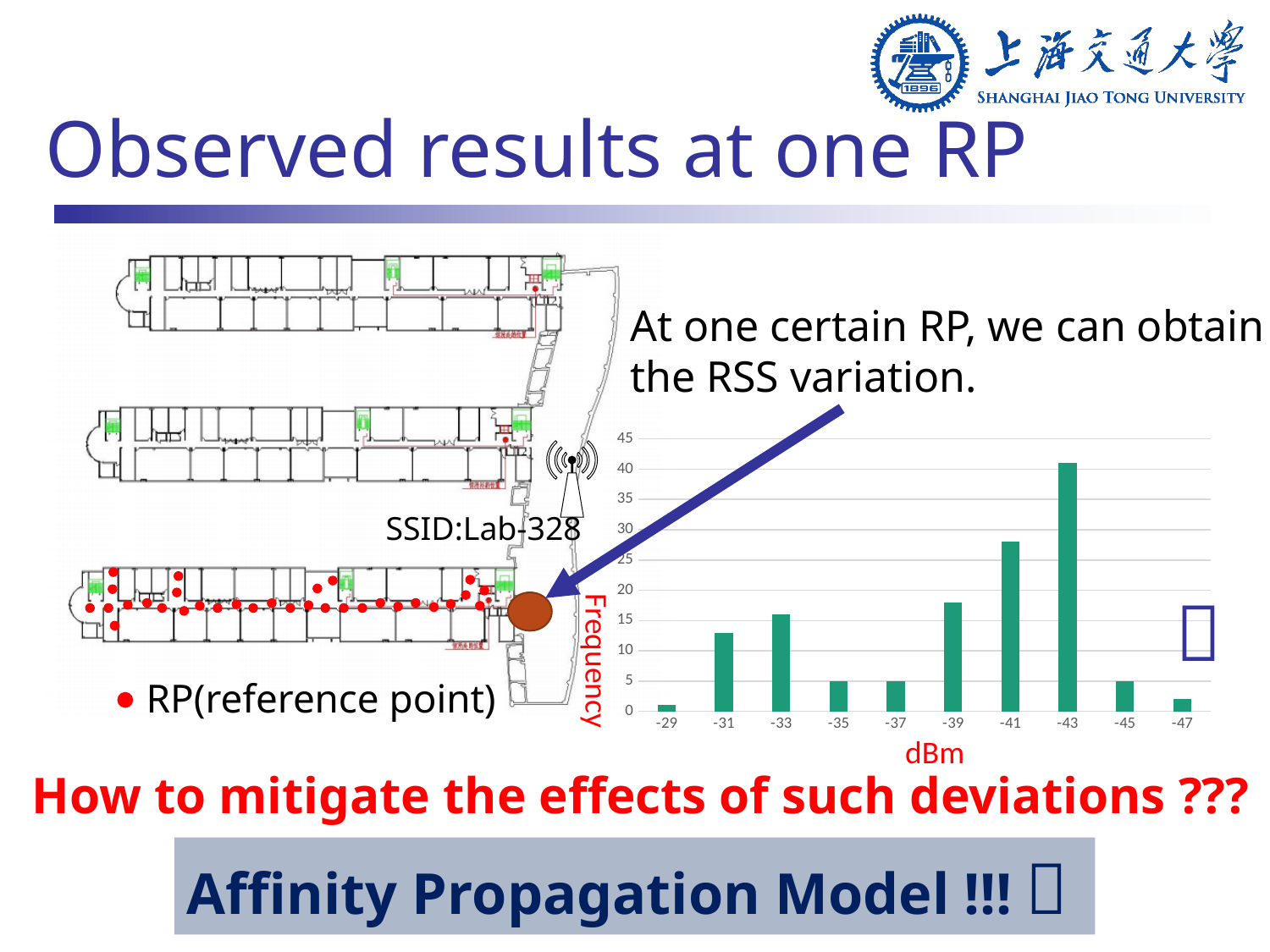
Which has a higher frequency, -31 dBm or -39 dBm? -39 Which has a higher frequency, -41 dBm or -33 dBm? -41 What is the label of the vertical axis of the chart? Frequency Which dBm value has the highest frequency in the chart? -43 Is the frequency for -41 dBm greater or less than 25? greater Is the frequency for -41 dBm greater or less than 30? less How many dBm categories are shown on the x axis of the chart? 10 Is the frequency for -39 dBm greater or less than 20? less What kind of chart is shown on the slide? bar chart